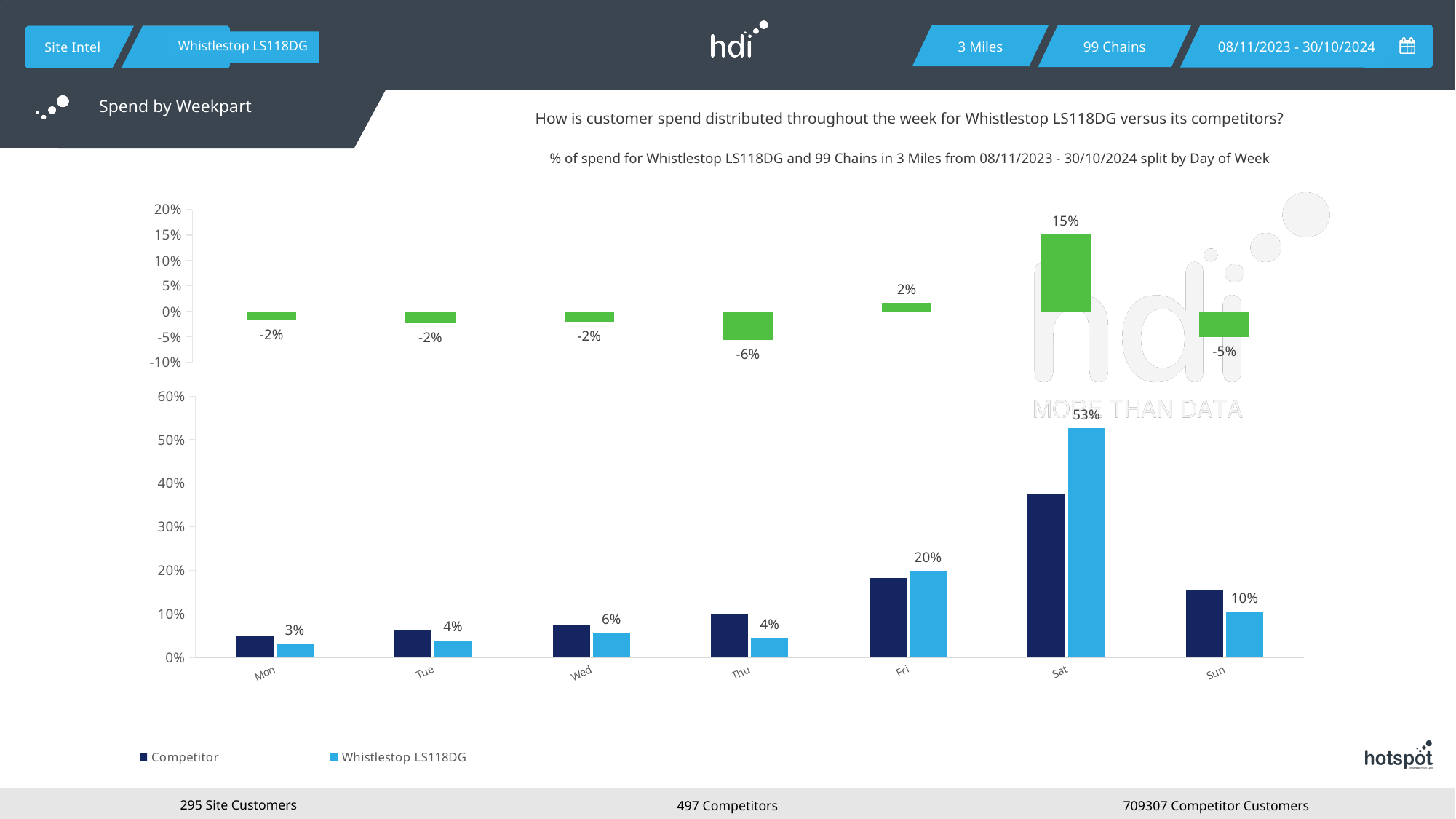
In the bottom bar chart, what is the value for Whistlestop LS118DG on Wed? 6% In the bottom bar chart, is the Competitor value for Sat greater or less than 30%? greater In the bottom bar chart, what is the value for Whistlestop LS118DG on Fri? 20% In the bottom bar chart, which day has the highest value for Whistlestop LS118DG? Sat In the top chart, what is the value shown for Thu? -6% In the bottom bar chart, which day has the lowest value for Whistlestop LS118DG? Mon In the bottom bar chart, what is the difference between the Whistlestop LS118DG values for Sat and Fri? 33% In the top chart, what is the value shown for Sat? 15% How many days of the week are shown on the x axis of the bottom bar chart? 7 In the bottom bar chart, what is the value for Whistlestop LS118DG on Sat? 53% How many series does the legend of the bottom bar chart list? 2 In the bottom bar chart, which is larger on Sun: the Competitor bar or the Whistlestop LS118DG bar? Competitor